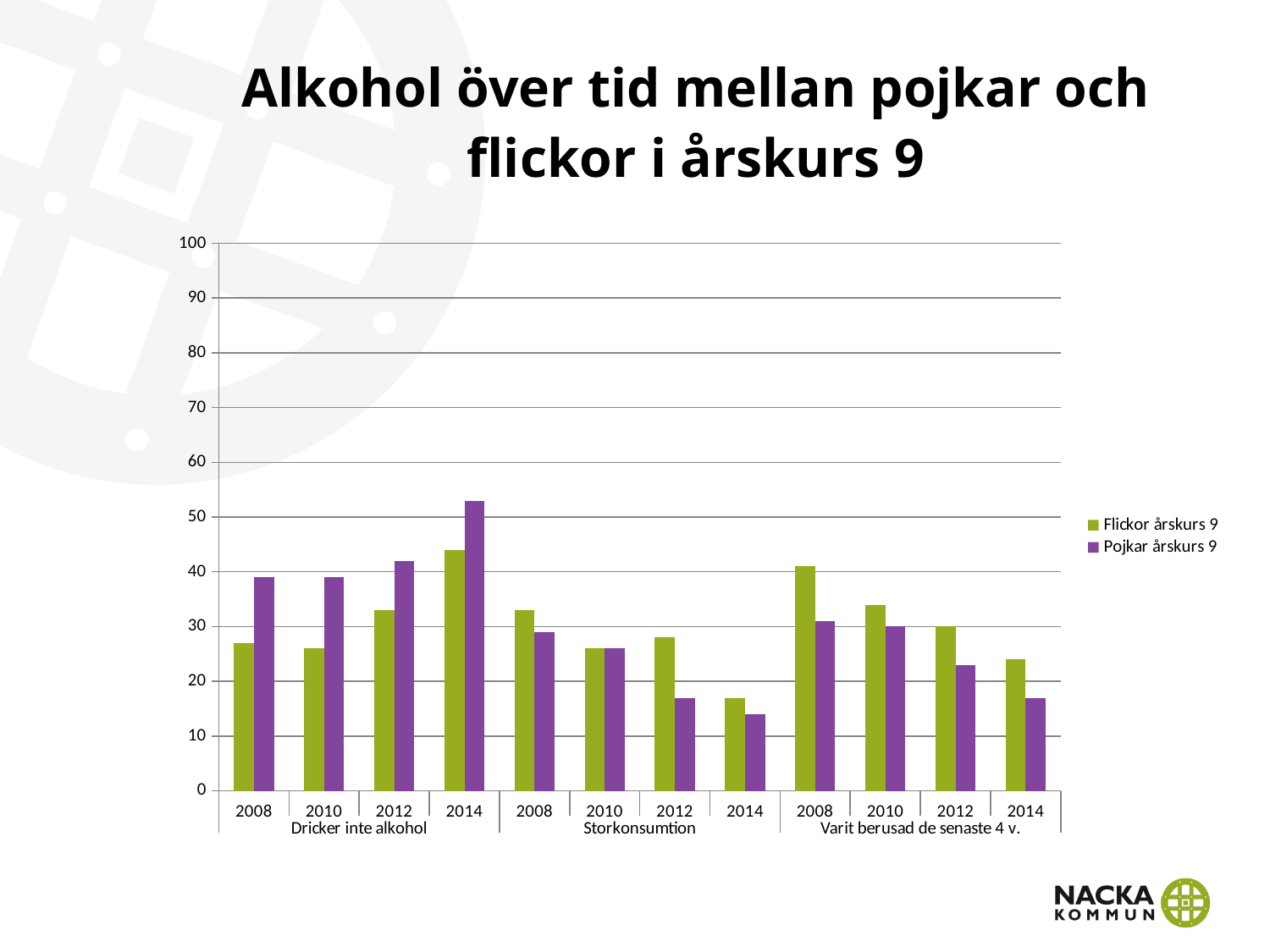
Is the value for Pojkar årskurs 9 in 2012 under Storkonsumtion greater or less than 20? less How many series does the legend list? 2 Which bar is the highest in the whole chart? Pojkar årskurs 9, 2014, Dricker inte alkohol In 2012 under Dricker inte alkohol, which series has the larger value, Flickor årskurs 9 or Pojkar årskurs 9? Pojkar årskurs 9 What are the two series named in the legend? Flickor årskurs 9 and Pojkar årskurs 9 Do the Flickor årskurs 9 values under Varit berusad de senaste 4 v. rise or fall from 2008 to 2014? fall Is the value for Pojkar årskurs 9 in 2014 under Dricker inte alkohol greater or less than 50? greater Is the value for Flickor årskurs 9 in 2014 under Storkonsumtion greater or less than 20? less In 2008 under Varit berusad de senaste 4 v., which series has the larger value, Flickor årskurs 9 or Pojkar årskurs 9? Flickor årskurs 9 What kind of chart is shown on the slide? bar chart How many year categories are shown along the x axis in total? 12 Do the Pojkar årskurs 9 values under Dricker inte alkohol rise or fall from 2008 to 2014? rise